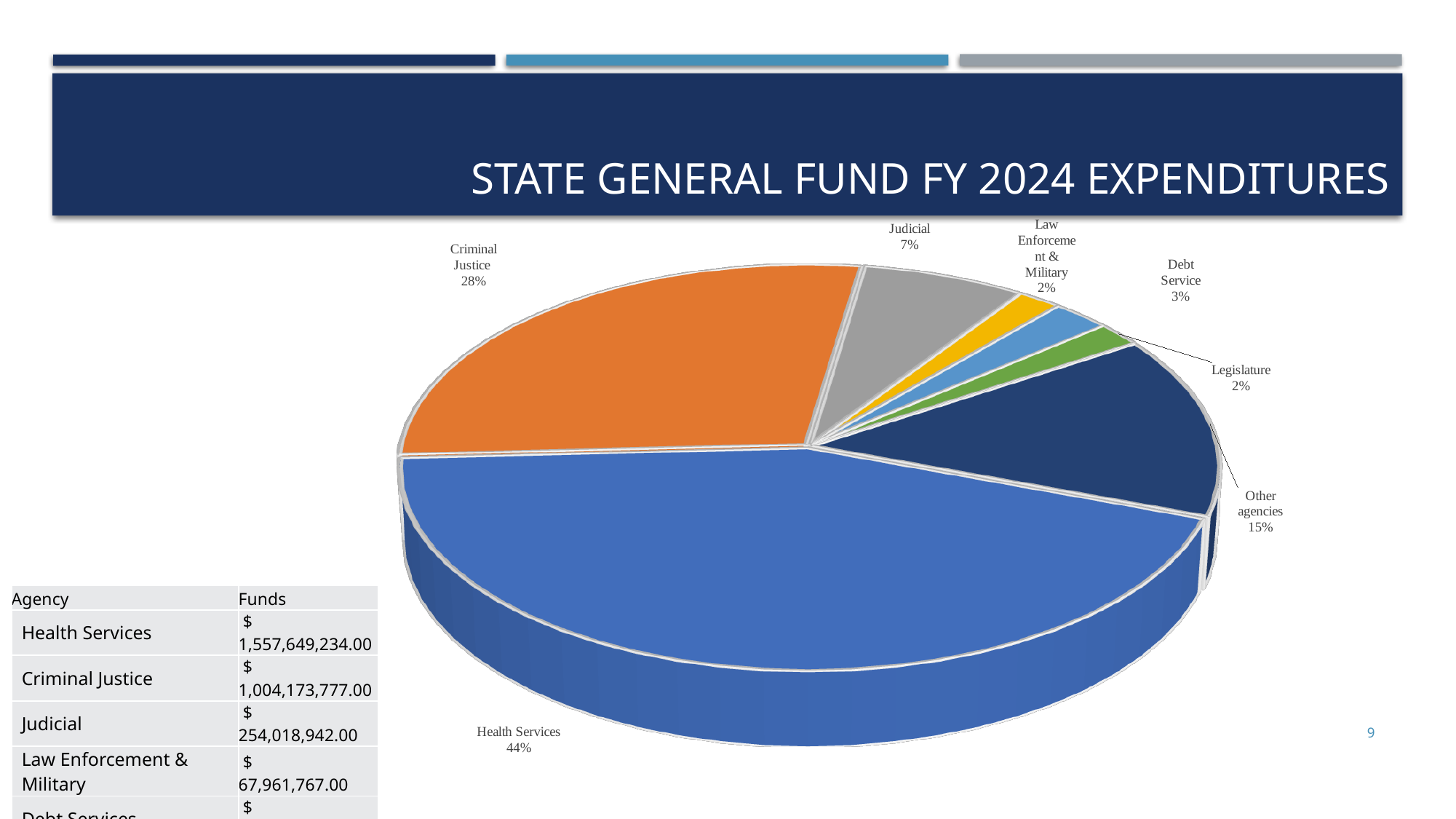
What is the difference in percentage points between the Health Services share and the Criminal Justice share? 16 Which category has the largest slice of the pie? Health Services What colour is the Criminal Justice slice of the pie? orange What kind of chart is shown on the slide? pie chart What share of the pie does Judicial represent? 7% Which is larger, the share for Criminal Justice or the share for Other agencies? Criminal Justice What share of the pie does Debt Service represent? 3% What share of the pie does Other agencies represent? 15% What is the title of the chart on the slide? STATE GENERAL FUND FY 2024 EXPENDITURES How many slices does the pie chart have? 7